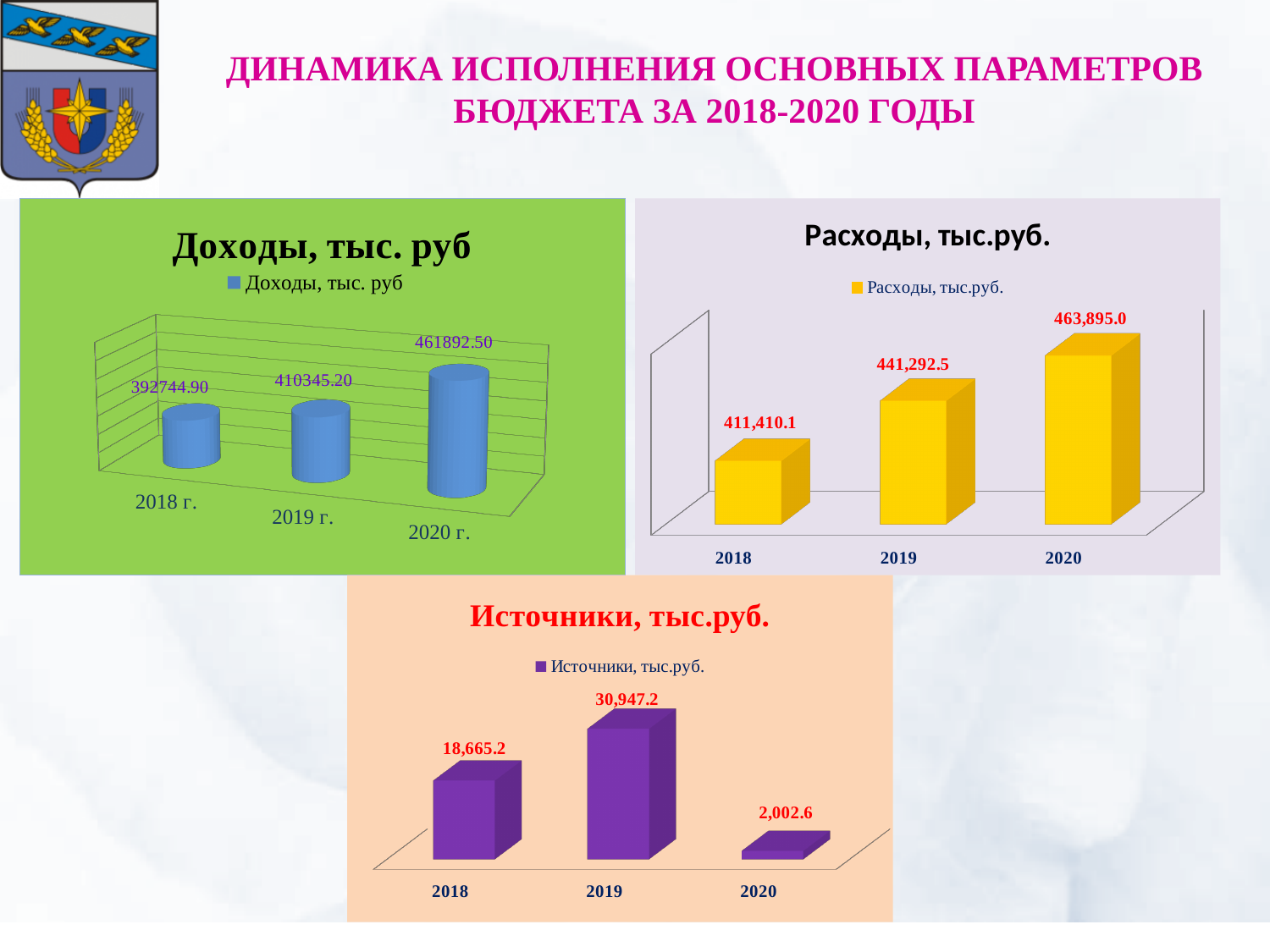
In the chart titled "Расходы, тыс.руб.", what is the value for 2018? 411,410.1 In the chart titled "Расходы, тыс.руб.", which year has the lowest value? 2018 In the chart titled "Доходы, тыс. руб", do the values rise or fall from 2018 г. to 2020 г.? rise In the chart titled "Источники, тыс.руб.", what is the value for 2020? 2,002.6 In the chart titled "Доходы, тыс. руб", which year has the highest value? 2020 г. In the chart titled "Расходы, тыс.руб.", what is the difference between the 2020 and 2019 values? 22,602.5 In the chart titled "Источники, тыс.руб.", which year has the highest value? 2019 What kind of chart is the chart titled "Расходы, тыс.руб."? bar chart In the chart titled "Источники, тыс.руб.", what is the difference between the 2019 and 2018 values? 12,282.0 In the chart titled "Доходы, тыс. руб", what is the difference between the 2020 г. and 2019 г. values? 51547.30 In the chart titled "Источники, тыс.руб.", how many years are shown on the x axis? 3 In the chart titled "Доходы, тыс. руб", what is the value for 2019 г.? 410345.20